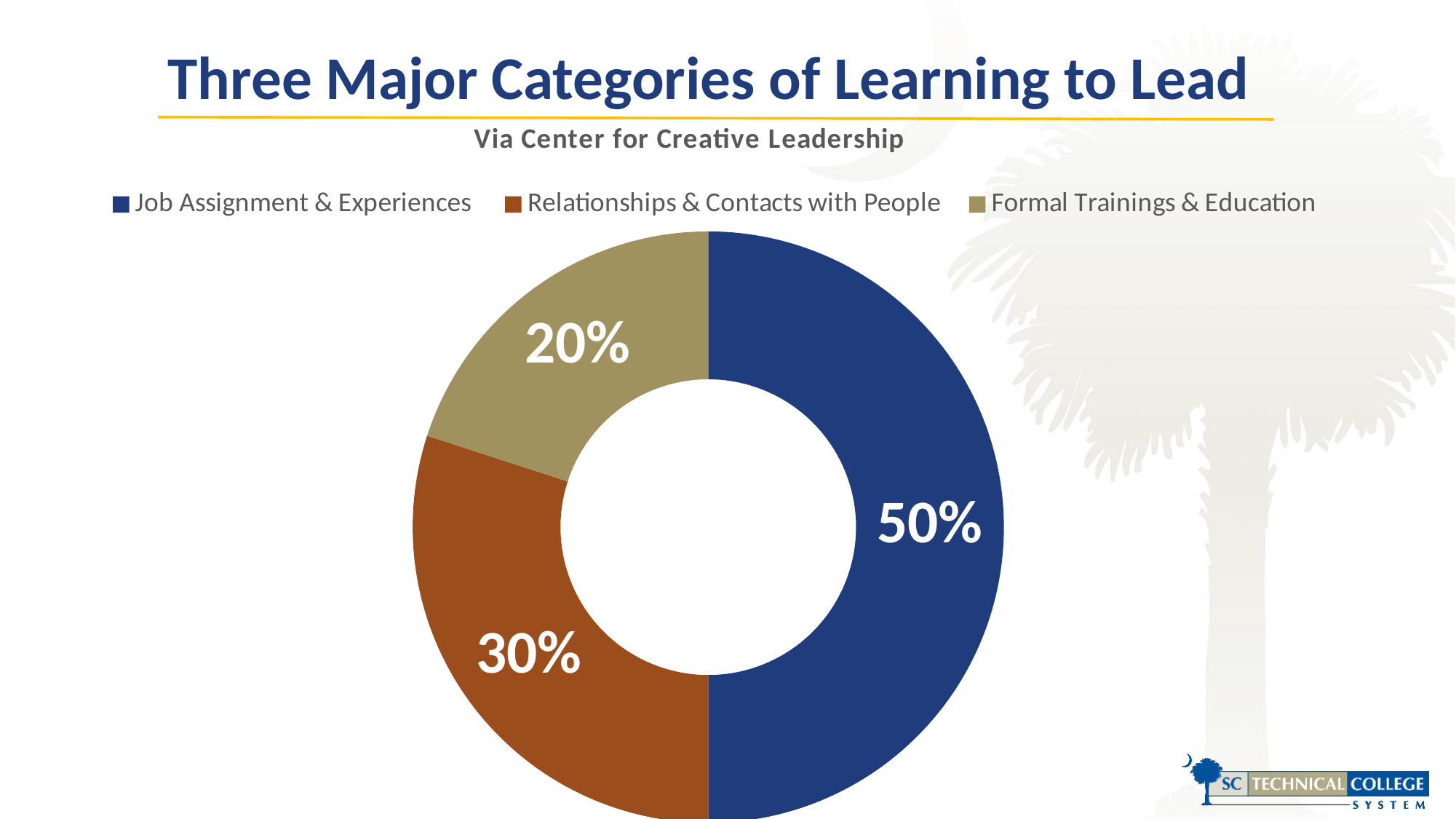
Which is larger: the share for Relationships & Contacts with People or the share for Formal Trainings & Education? Relationships & Contacts with People Which category has the largest share in the chart? Job Assignment & Experiences Which category has the smallest share in the chart? Formal Trainings & Education What percentage does the chart show for Relationships & Contacts with People? 30% Which colour represents Formal Trainings & Education in the chart? Tan (khaki) What kind of chart is shown on the slide? Doughnut (pie) chart How many categories are shown in the chart? 3 What percentage does the chart show for Job Assignment & Experiences? 50% What is the title of the chart on the slide? Via Center for Creative Leadership What is the difference in percentage points between Relationships & Contacts with People and Formal Trainings & Education? 10 What percentage does the chart show for Formal Trainings & Education? 20% What is the difference in percentage points between Job Assignment & Experiences and Formal Trainings & Education? 30